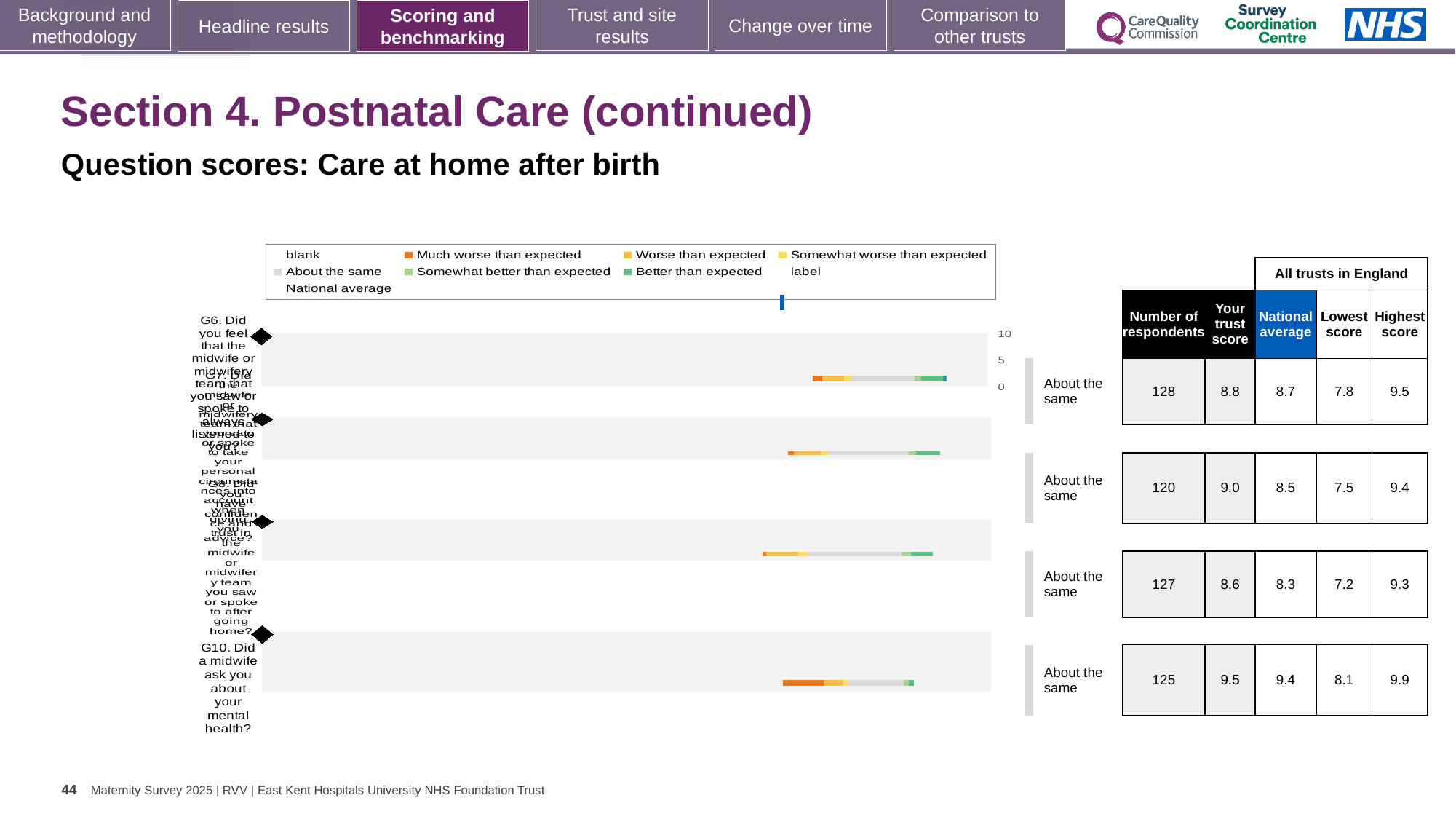
What benchmark category is shown for G10 'Did a midwife ask you about your mental health?' About the same By how much does the trust score for G10 exceed the national average for G10? 0.1 What is the highest score across all trusts in England for G10 'Did a midwife ask you about your mental health?' 9.9 What is the national average for G10 'Did a midwife ask you about your mental health?' 9.4 What is the trust score for G10 'Did a midwife ask you about your mental health?' 9.5 What is the number of respondents for G10 'Did a midwife ask you about your mental health?' 125 What kind of chart is shown on the slide? Bar chart What is the number of respondents for the first question, G6? 128 What is the trust score for the first question, G6? 8.8 Which question has the highest 'Your trust score' value? G10 (9.5) For the first question, G6, which is larger: the trust score or the national average? Trust score (8.8) How many questions (bars) are plotted in the chart? 4